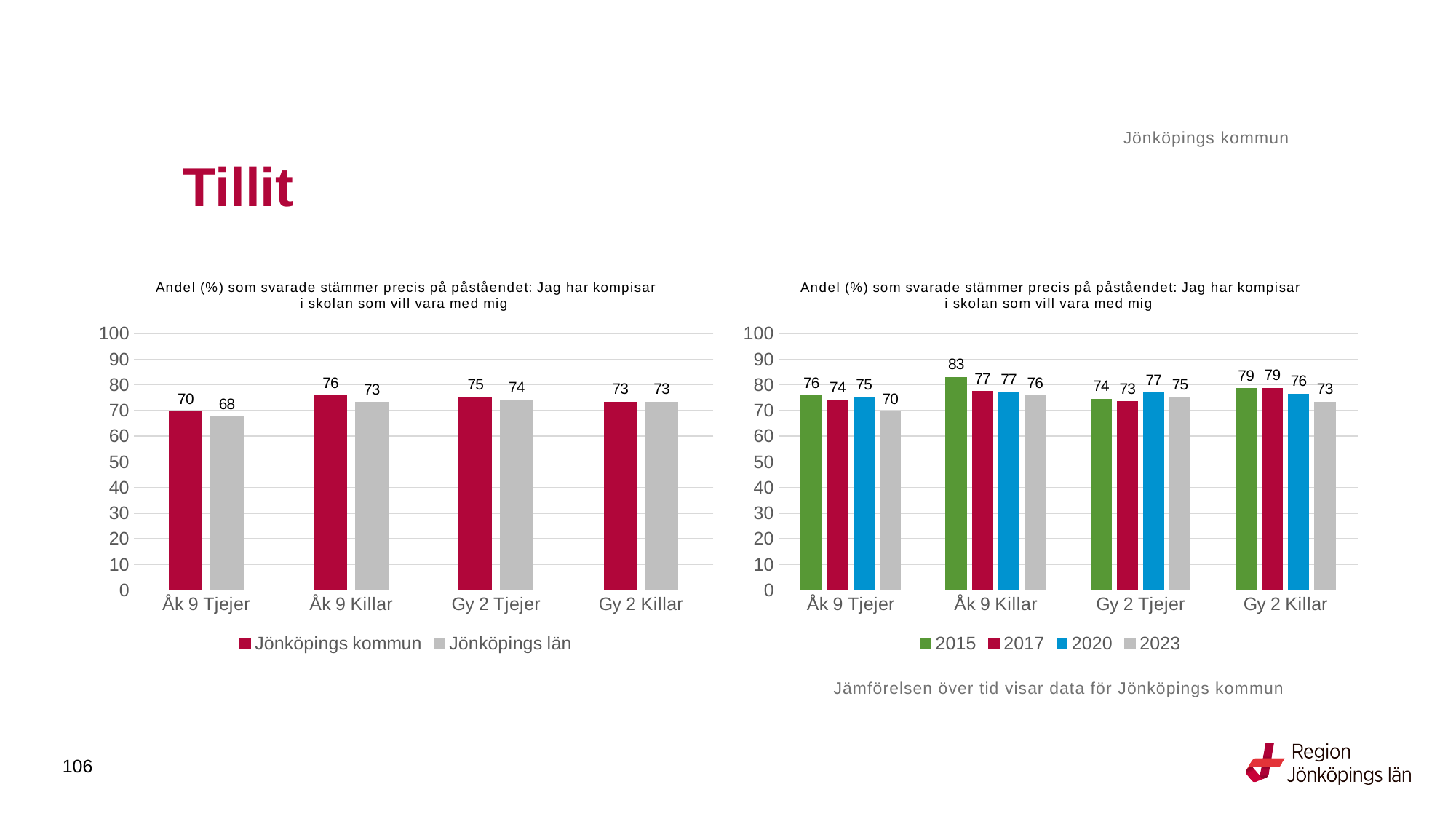
In the left chart, what is the difference between Jönköpings kommun and Jönköpings län for Åk 9 Killar? 3 In the right chart, what is the value for 2015 for Åk 9 Killar? 83 In the right chart, what is the value for 2023 for Gy 2 Killar? 73 In the left chart, how many series does the legend list? 2 In the left chart, what is the value for Jönköpings kommun for Åk 9 Tjejer? 70 In the left chart, what is the value for Jönköpings län for Åk 9 Killar? 73 In the right chart, how many series does the legend list? 4 In the right chart, is the value for 2020 for Gy 2 Tjejer larger or smaller than the value for 2017 for Gy 2 Tjejer? larger What kind of chart is the right chart? bar chart In the right chart, which category has the highest value for 2015? Åk 9 Killar In the left chart, which category has the lowest value for Jönköpings län? Åk 9 Tjejer In the left chart, which category has the highest value for Jönköpings kommun? Åk 9 Killar